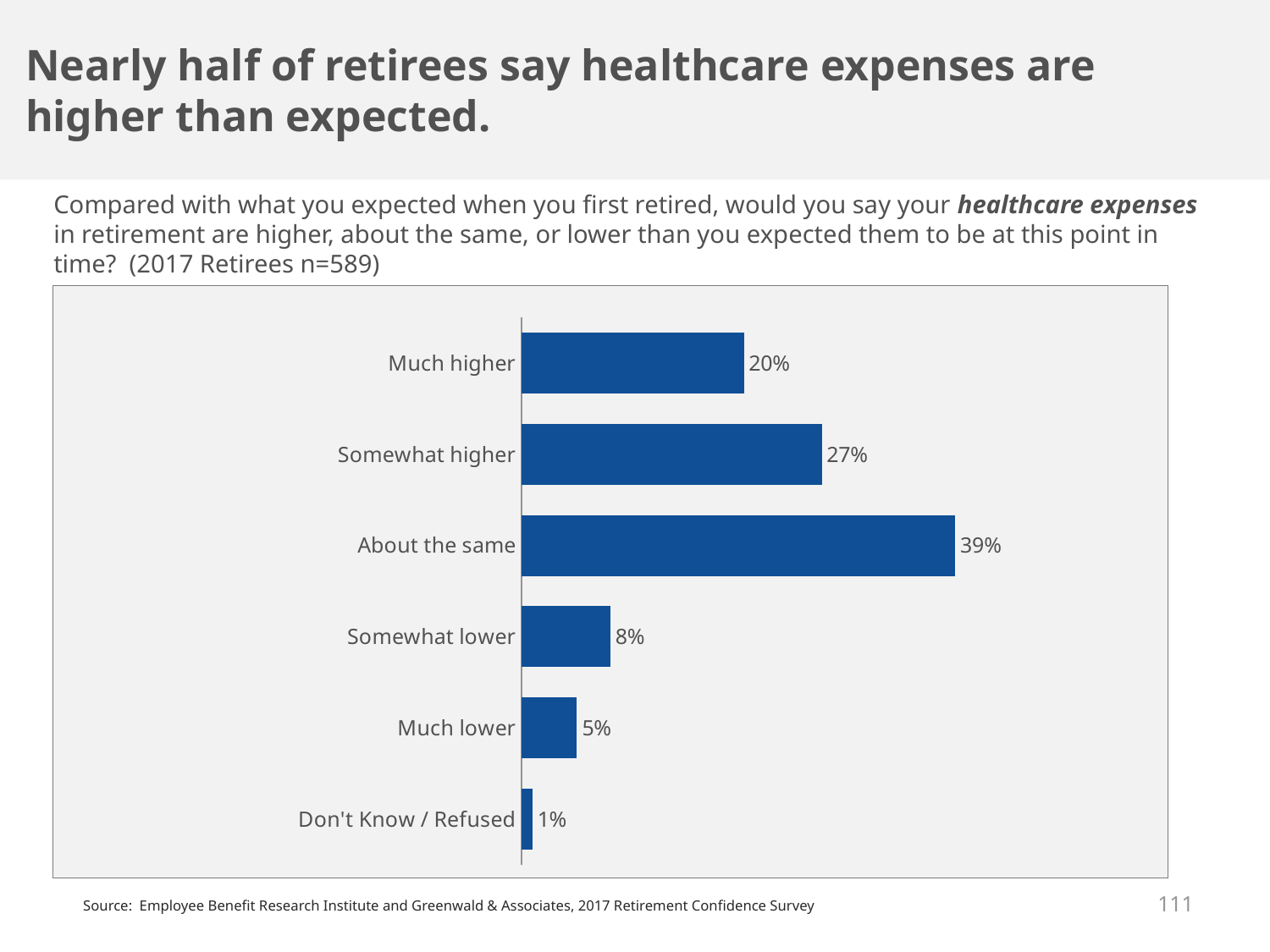
What is the value for 'Don't Know / Refused'? 1% What percentage of retirees said their healthcare expenses were about the same as expected? 39% What is the value for 'Much lower'? 5% Which category has the highest value? About the same What kind of chart is shown on the slide? Bar chart What is the combined value of 'Much higher' and 'Somewhat higher'? 47% Which is larger, 'Somewhat lower' or 'Much lower'? Somewhat lower Which category has the lowest value? Don't Know / Refused What is the value for 'Somewhat higher'? 27% What percentage of retirees said their healthcare expenses were much higher than expected? 20% How many categories are shown in the chart? 6 What is the difference between 'Somewhat higher' and 'Much higher'? 7%